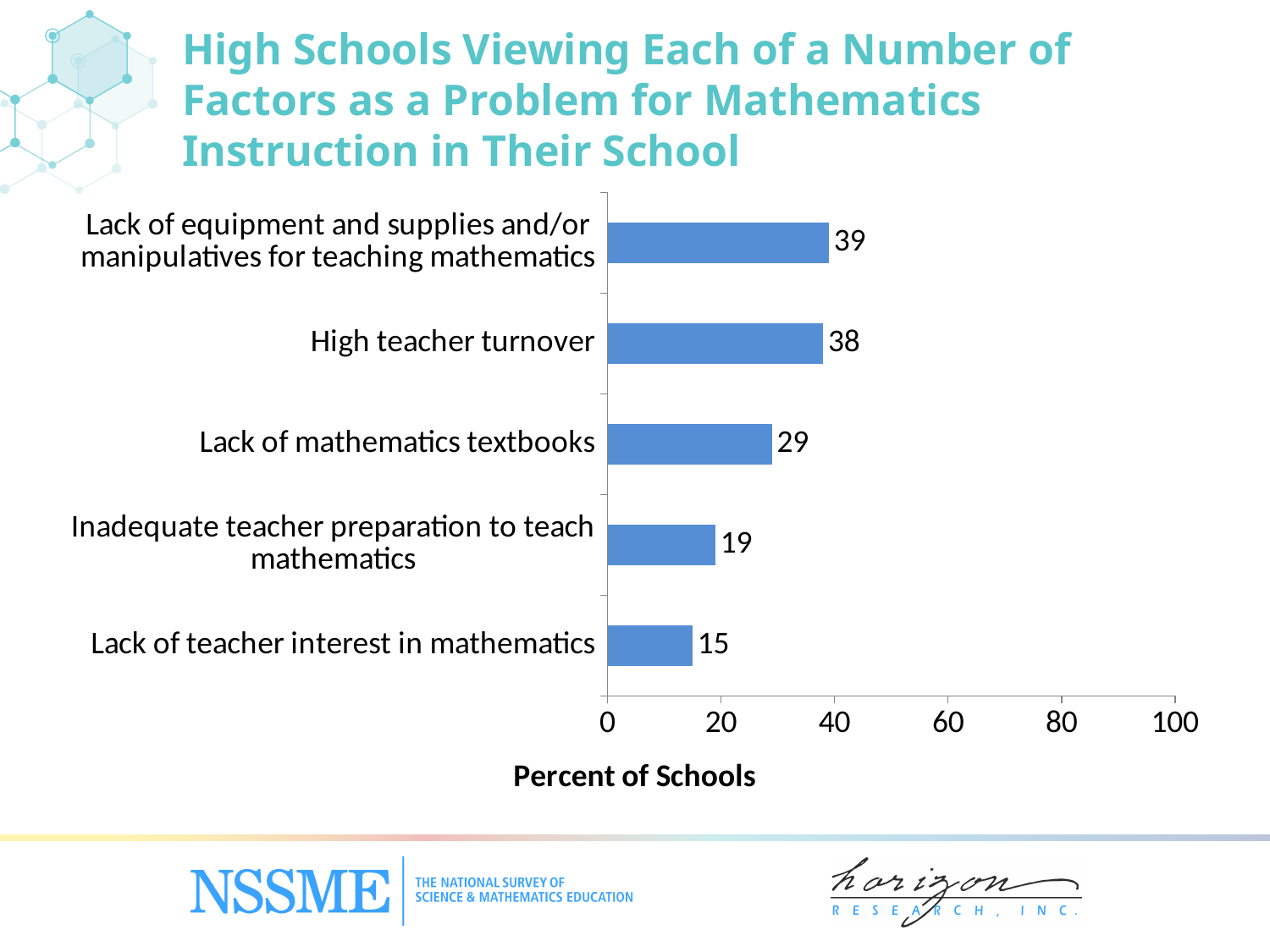
Which factor has the highest percent of schools? Lack of equipment and supplies and/or manipulatives for teaching mathematics What percent of high schools view lack of equipment and supplies and/or manipulatives for teaching mathematics as a problem? 39 What is the difference between the values for lack of mathematics textbooks and lack of teacher interest in mathematics? 14 How many factors are shown in the chart? 5 What is the value for inadequate teacher preparation to teach mathematics? 19 What kind of chart is shown on the slide? Bar chart Which is larger: the value for lack of mathematics textbooks or the value for inadequate teacher preparation to teach mathematics? Lack of mathematics textbooks Is the value for high teacher turnover greater or less than 40? less What is the value for lack of mathematics textbooks? 29 What is the value for high teacher turnover? 38 Which factor has the lowest percent of schools? Lack of teacher interest in mathematics What is the label of the horizontal axis? Percent of Schools